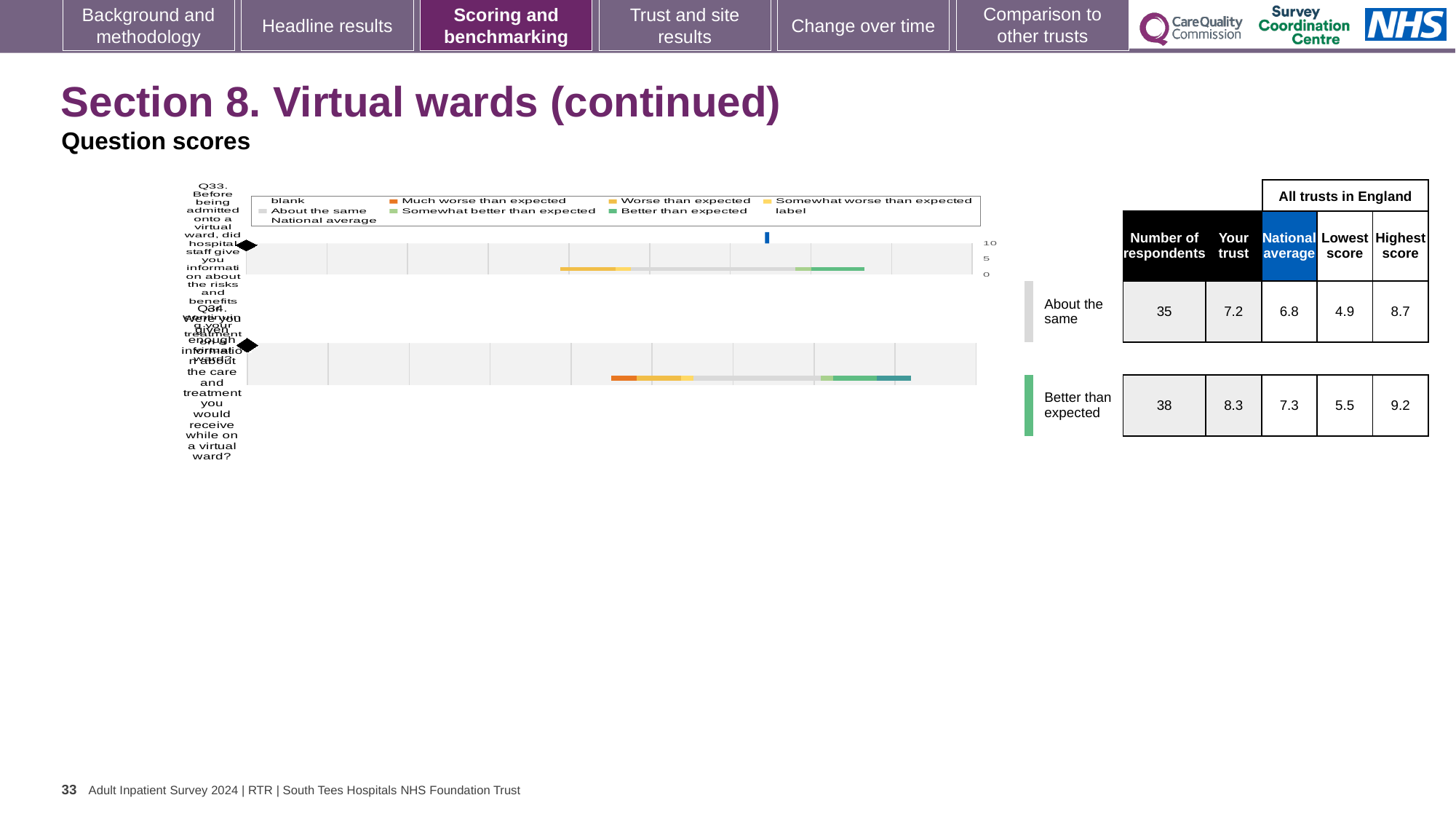
What is the difference between the 'Your trust' score and the national average for Q34 (Better than expected)? 1.0 How many questions (rows) are plotted in the chart? 2 What is the national average for Q34 (Better than expected)? 7.3 What kind of chart is shown on the slide? bar chart Which benchmark category is Q33 rated as? About the same How many respondents answered Q33 (About the same)? 35 What is the 'Your trust' score for Q33 (About the same)? 7.2 What is the 'Your trust' score for Q34 (Better than expected)? 8.3 Which benchmark category is Q34 rated as? Better than expected What is the highest score among all trusts in England for Q33 (About the same)? 8.7 Which question has the higher 'Your trust' score, Q33 or Q34? Q34 What colour is used in the legend for 'Much worse than expected'? orange